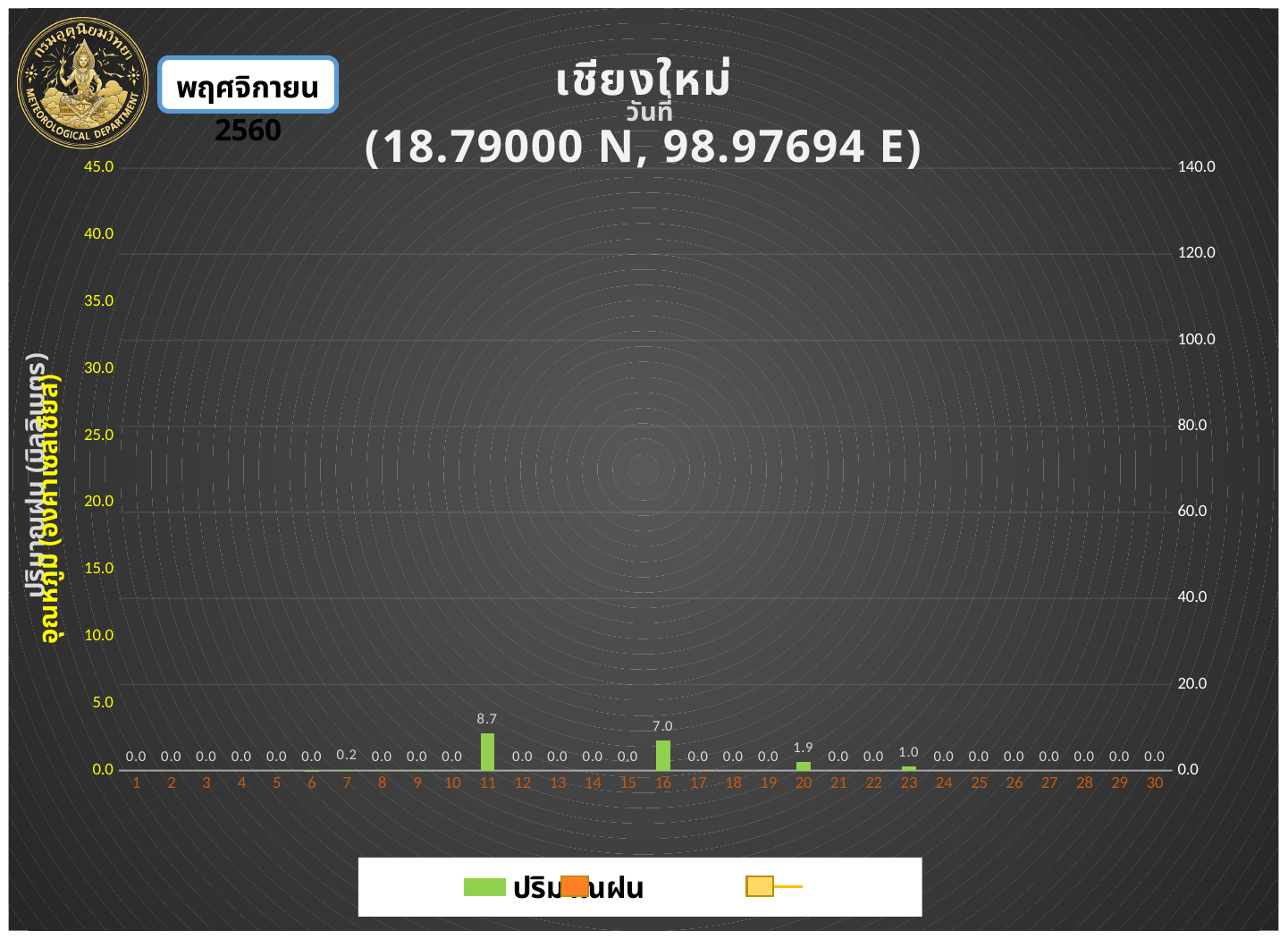
What kind of chart is shown on the slide? bar chart What is the rainfall value shown for day 11? 8.7 Which is larger, the rainfall value for day 20 or for day 23? day 20 Which day has the highest rainfall value? 11 Is the rainfall value for day 11 greater or less than 10.0 on the left axis? less What is the rainfall value shown for day 23? 1.0 What is the difference between the rainfall values for day 11 and day 16? 1.7 How many days are shown on the x axis? 30 What is the rainfall value shown for day 7? 0.2 What is the highest value shown on the right-hand axis? 140.0 What is the rainfall value shown for day 20? 1.9 What is the rainfall value shown for day 16? 7.0